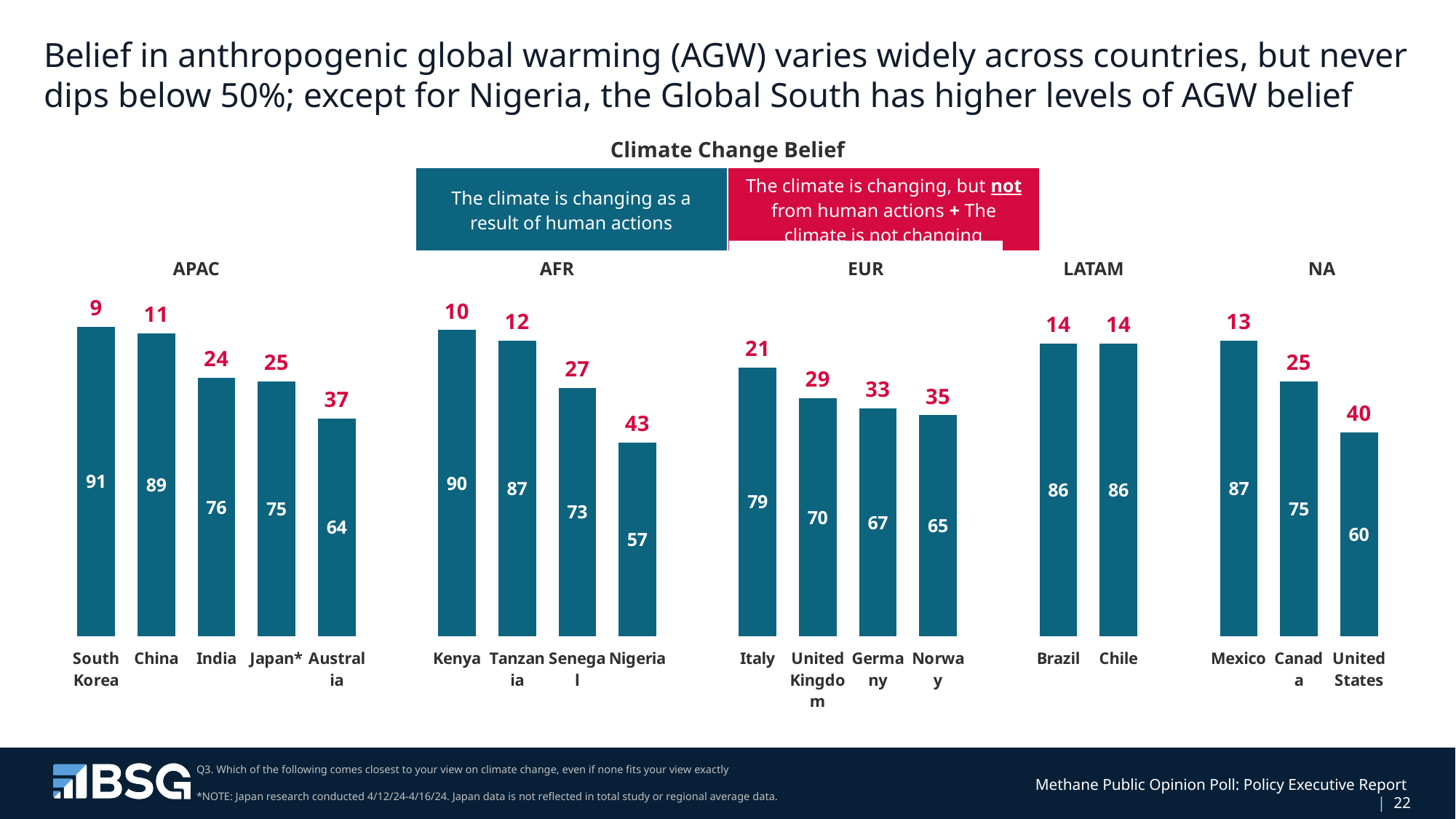
What is the title of the chart? Climate Change Belief What is the red value shown above the bar for Nigeria? 43 What is the value for Germany for 'The climate is changing as a result of human actions'? 67 What is the value for South Korea for 'The climate is changing as a result of human actions'? 91 Which region contains Brazil and Chile in the chart? LATAM What kind of chart is shown on the slide? Bar chart How many countries are shown in the chart? 18 Which country has the highest value for 'The climate is changing as a result of human actions'? South Korea What is the difference between the values for Kenya and Nigeria for 'The climate is changing as a result of human actions'? 33 Which has a higher value for 'The climate is changing as a result of human actions', Italy or Norway? Italy Which country has the lowest value for 'The climate is changing as a result of human actions'? Nigeria How many regional groups are shown in the chart? 5